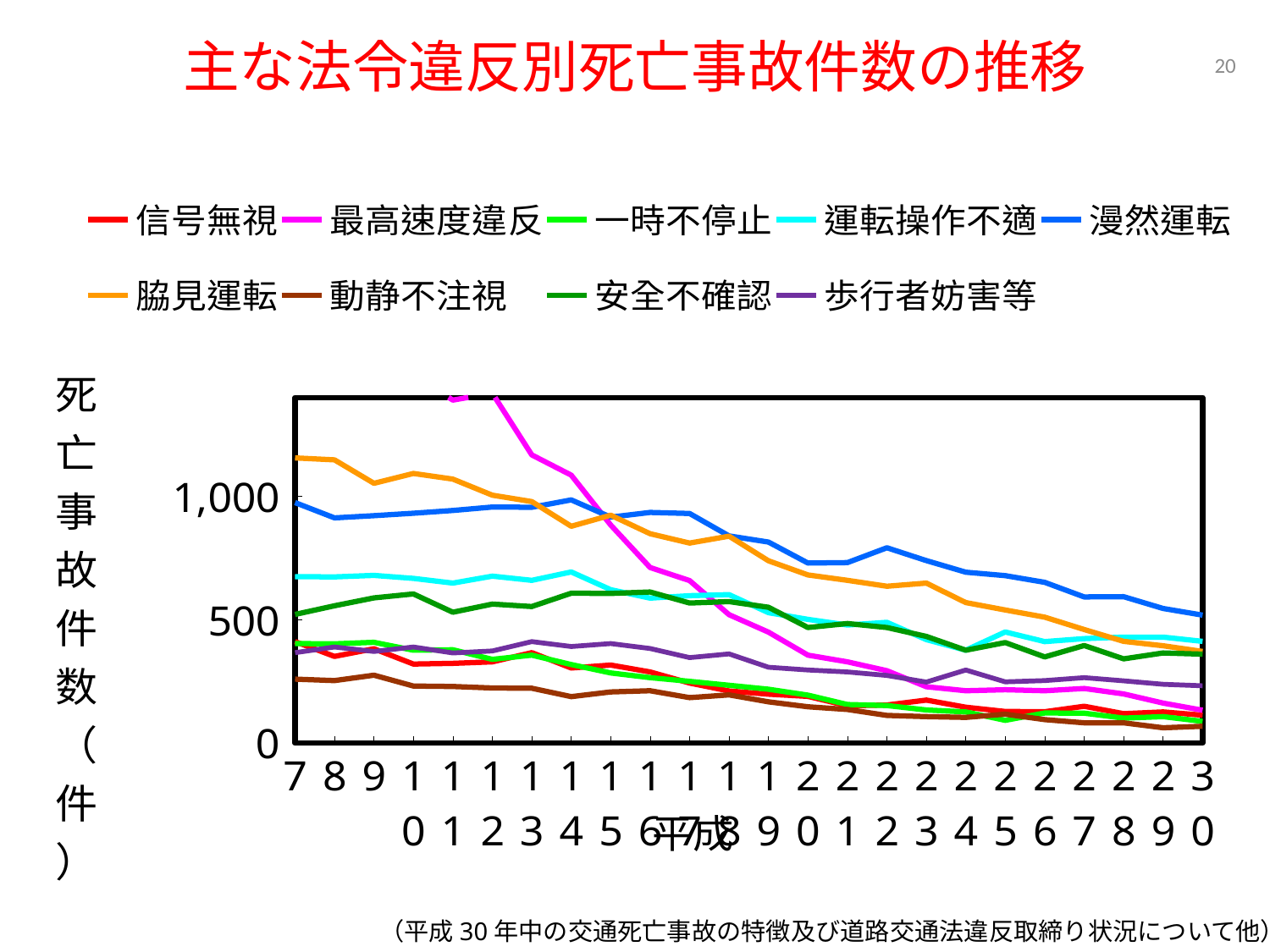
What kind of chart is shown on the slide? line chart Is the value for 動静不注視 in 平成7 greater or less than 500? less Does the value for 最高速度違反 rise or fall from 平成7 to 平成30? fall In 平成30, which is larger: 漫然運転 or 動静不注視? 漫然運転 Is the value for 漫然運転 in 平成7 greater or less than 500? greater Does the value for 脇見運転 rise or fall from 平成7 to 平成30? fall Which series has the highest value in 平成30? 漫然運転 What is the title of the chart? 主な法令違反別死亡事故件数の推移 Is the value for 脇見運転 in 平成7 greater or less than 1,000? greater How many years (points) are plotted along the x axis? 24 How many series does the legend list? 9